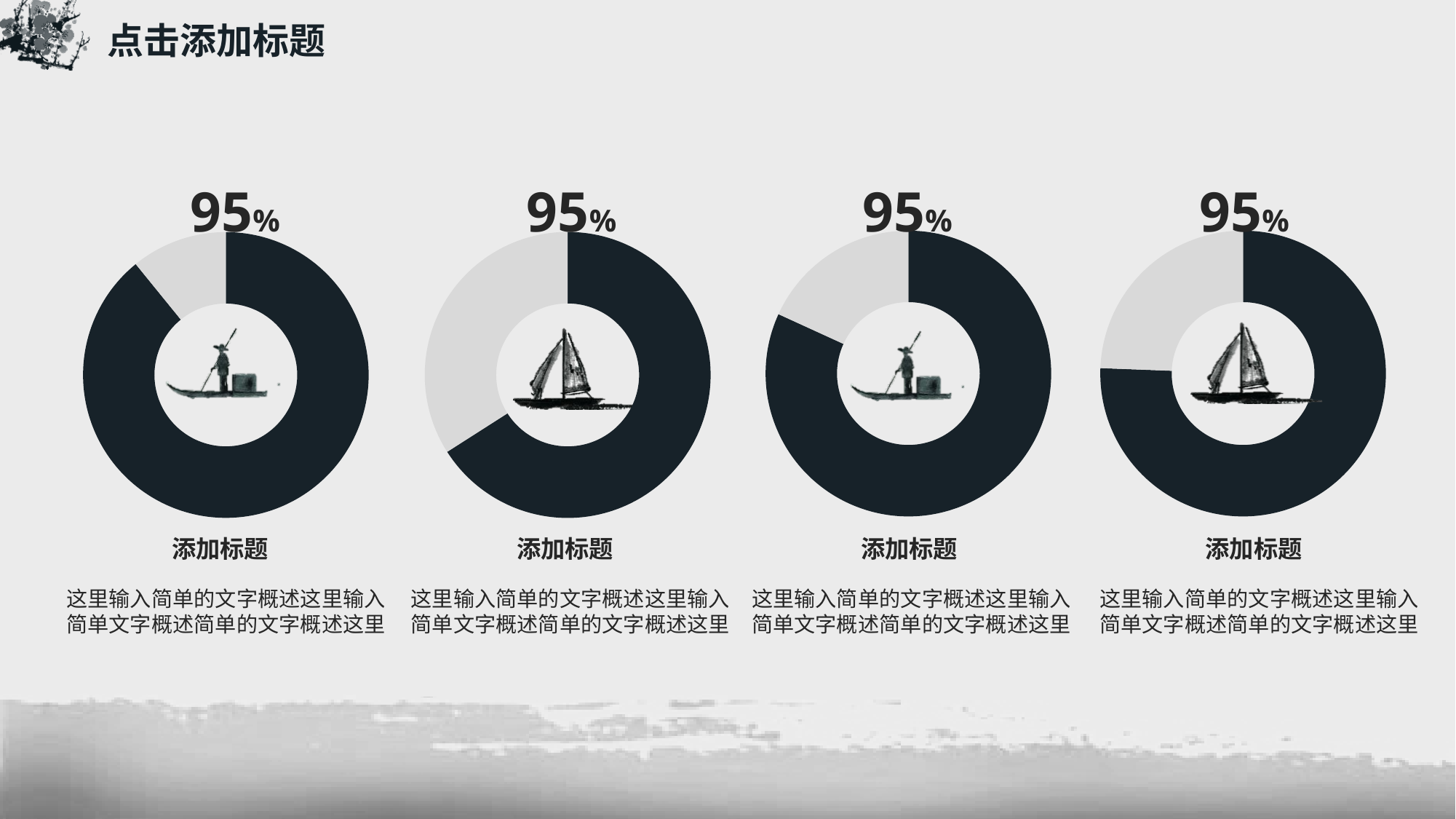
What kind of chart is used for each of the four figures on the slide? Donut chart What value is printed above the leftmost donut chart? 95% Which donut chart has the visually smallest dark segment? The second from the left What value is printed above the rightmost donut chart? 95% Do the four donut charts all display the same printed percentage? Yes, 95% What value is printed above the second donut chart from the left? 95% What colour is the larger segment in each donut chart? Dark navy/black What label appears directly below each donut chart? 添加标题 Is the dark segment of the leftmost donut chart larger or smaller than that of the second donut chart? Larger What value is printed above the third donut chart from the left? 95% How many donut charts are shown on the slide? 4